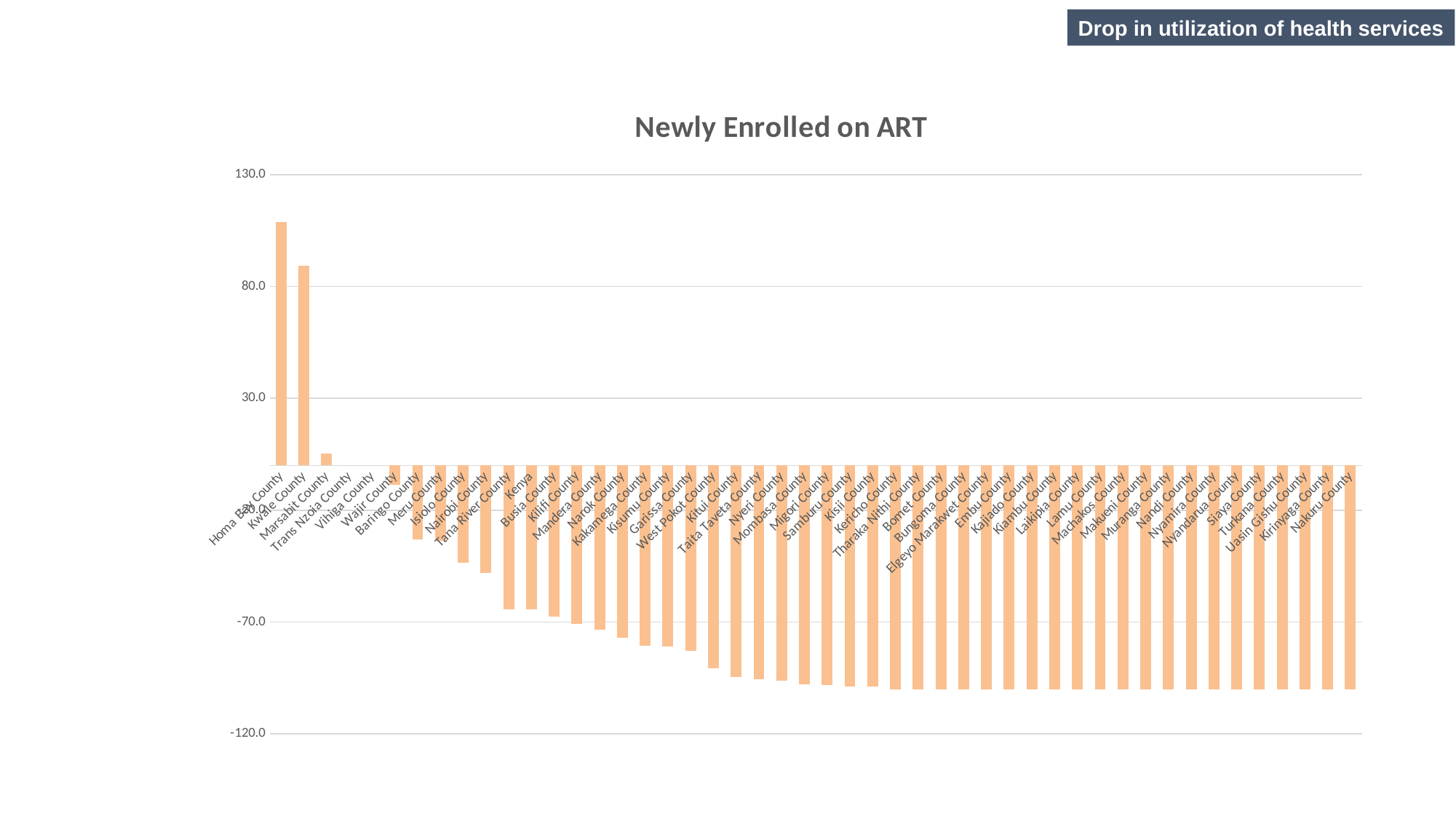
Do the values generally rise or fall moving from left to right along the x axis? fall Which is larger, the value for Homa Bay County or the value for Kwale County? Homa Bay County What kind of chart is shown on the slide? bar chart Is the value for Kwale County greater or less than 80? greater Which is larger, the value for Kenya or the value for Mombasa County? Kenya Which category has the highest value in the Newly Enrolled on ART chart? Homa Bay County Is the value for Marsabit County greater or less than 30? less Is the value for Nakuru County greater or less than -70? less What is the title of the chart? Newly Enrolled on ART